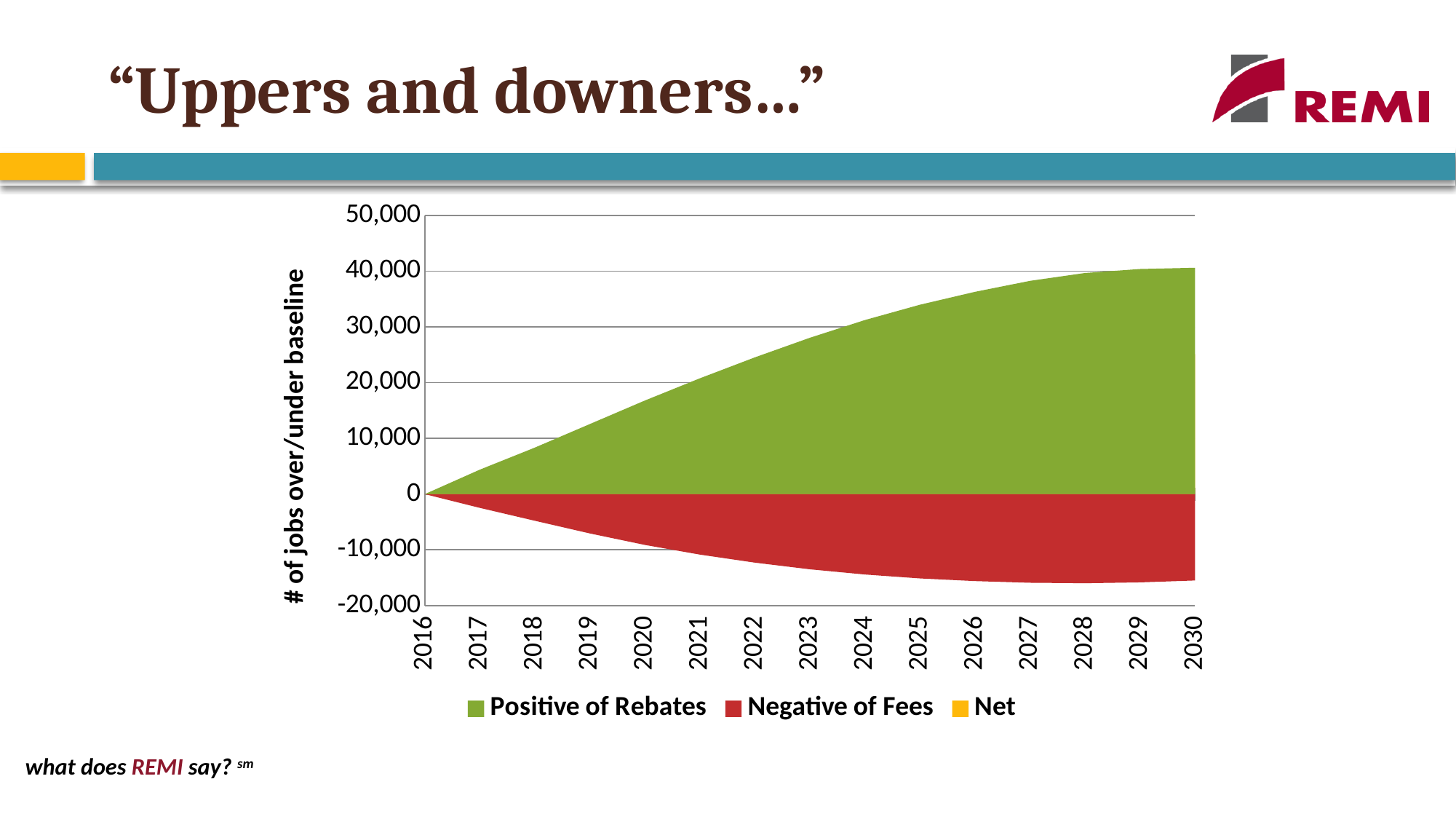
Is the value for Positive of Rebates in 2025 greater or less than 30,000? greater Is the value for Positive of Rebates in 2020 greater or less than 20,000? less Is the value for Negative of Fees in 2018 greater or less than -10,000? greater What kind of chart is shown on the slide? Area chart What is the title of the y axis? # of jobs over/under baseline How many series does the legend list? 3 In which year is Positive of Rebates at its lowest? 2016 Does the Positive of Rebates series rise or fall from 2016 to 2030? Rise What is the value of Positive of Rebates in 2016? 0 Does the Negative of Fees series rise or fall from 2016 to 2030? Fall How many years are shown along the x axis? 15